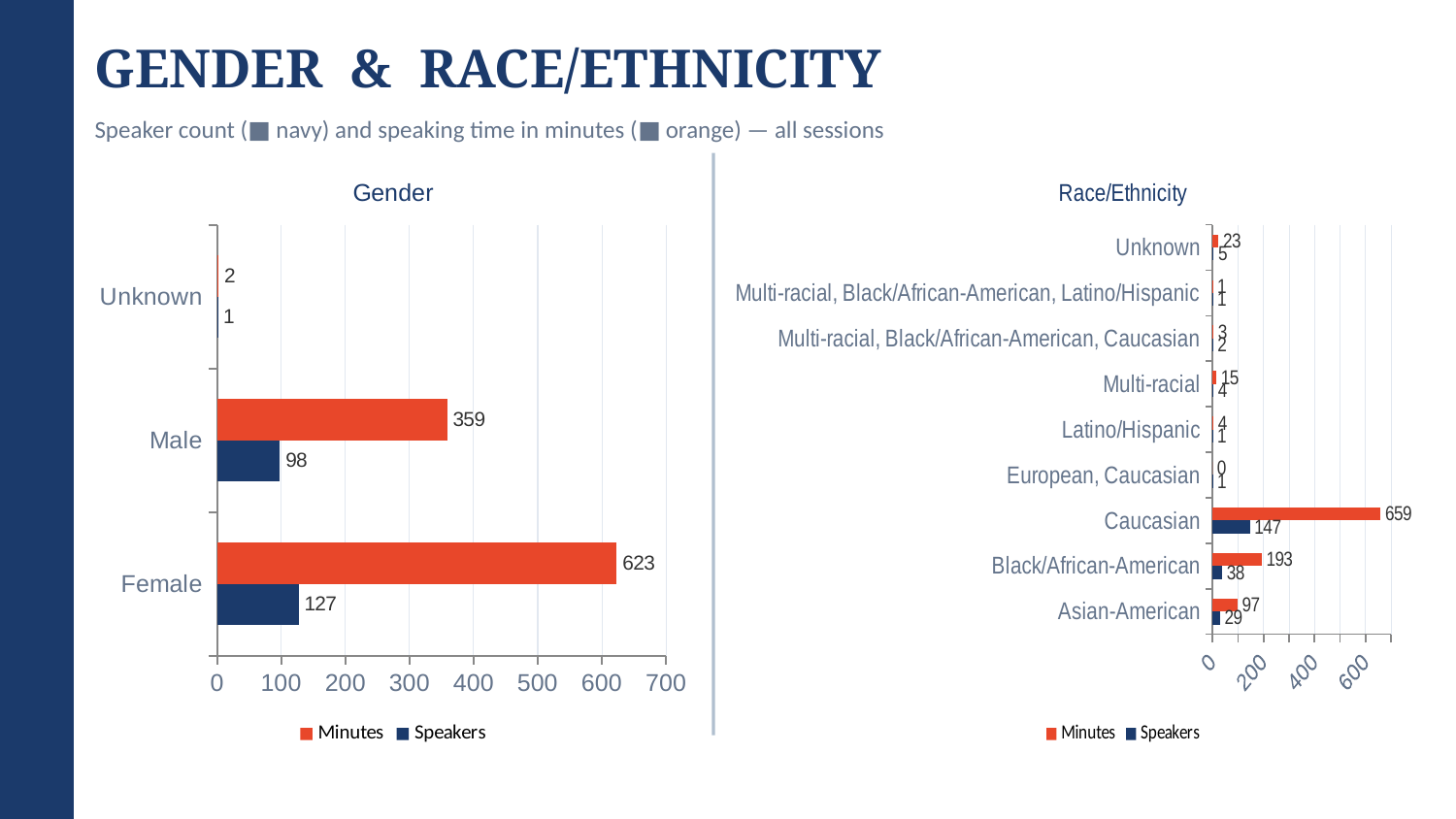
In the Race/Ethnicity chart, which has more speakers, Asian-American or Black/African-American? Black/African-American In the Race/Ethnicity chart, which category has the highest number of minutes? Caucasian In the Gender chart, which category has the lowest speaker count? Unknown In the Race/Ethnicity chart, what is the difference in speaker count between Caucasian and Asian-American? 118 In the Race/Ethnicity chart, what is the speaker count for Black/African-American? 38 In the Race/Ethnicity chart, how many minutes are shown for Caucasian? 659 In the Gender chart, how many minutes of speaking time are shown for Female? 623 In the Gender chart, what is the speaker count for Male? 98 What type of chart is the Gender chart? Bar chart How many series does the legend of the Race/Ethnicity chart list? 2 In the Gender chart, how many categories are shown on the vertical axis? 3 In the Gender chart, what is the difference in minutes between Female and Male? 264